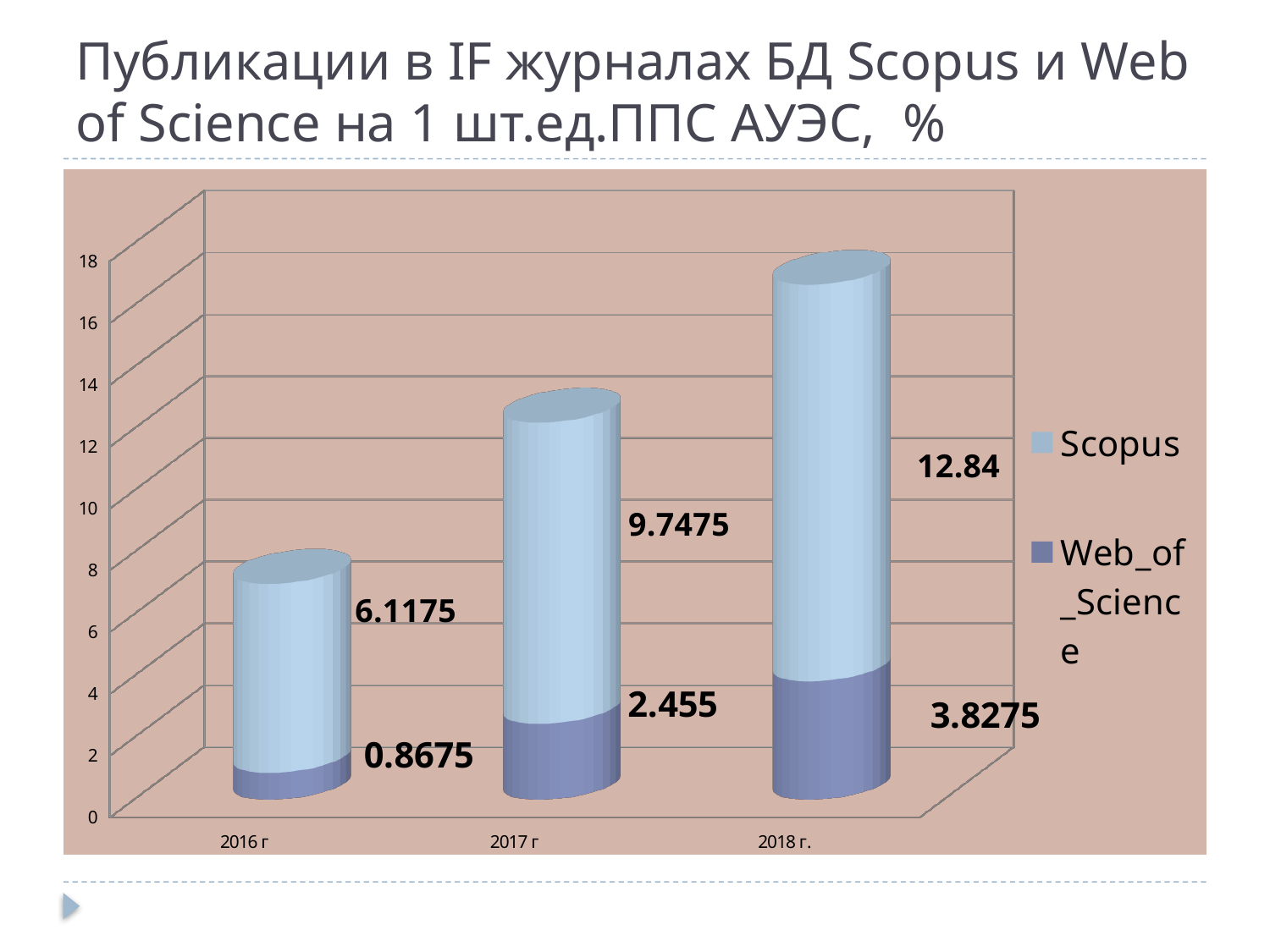
What is the difference between the Scopus values for 2018 г. and 2017 г? 3.0925 How many years are shown on the x axis? 3 What kind of chart is shown on the slide? Stacked bar chart What is the Web_of_Science value for 2018 г.? 3.8275 What is the Scopus value for 2017 г? 9.7475 Which year has the lowest Web_of_Science value? 2016 г What is the total of the stacked bar for 2016 г? 6.985 Which is larger, the Web_of_Science value for 2017 г or for 2016 г? 2017 г Which year has the highest Scopus value? 2018 г. How many series does the legend list? 2 What is the Scopus value for 2018 г.? 12.84 What is the Web_of_Science value for 2016 г? 0.8675